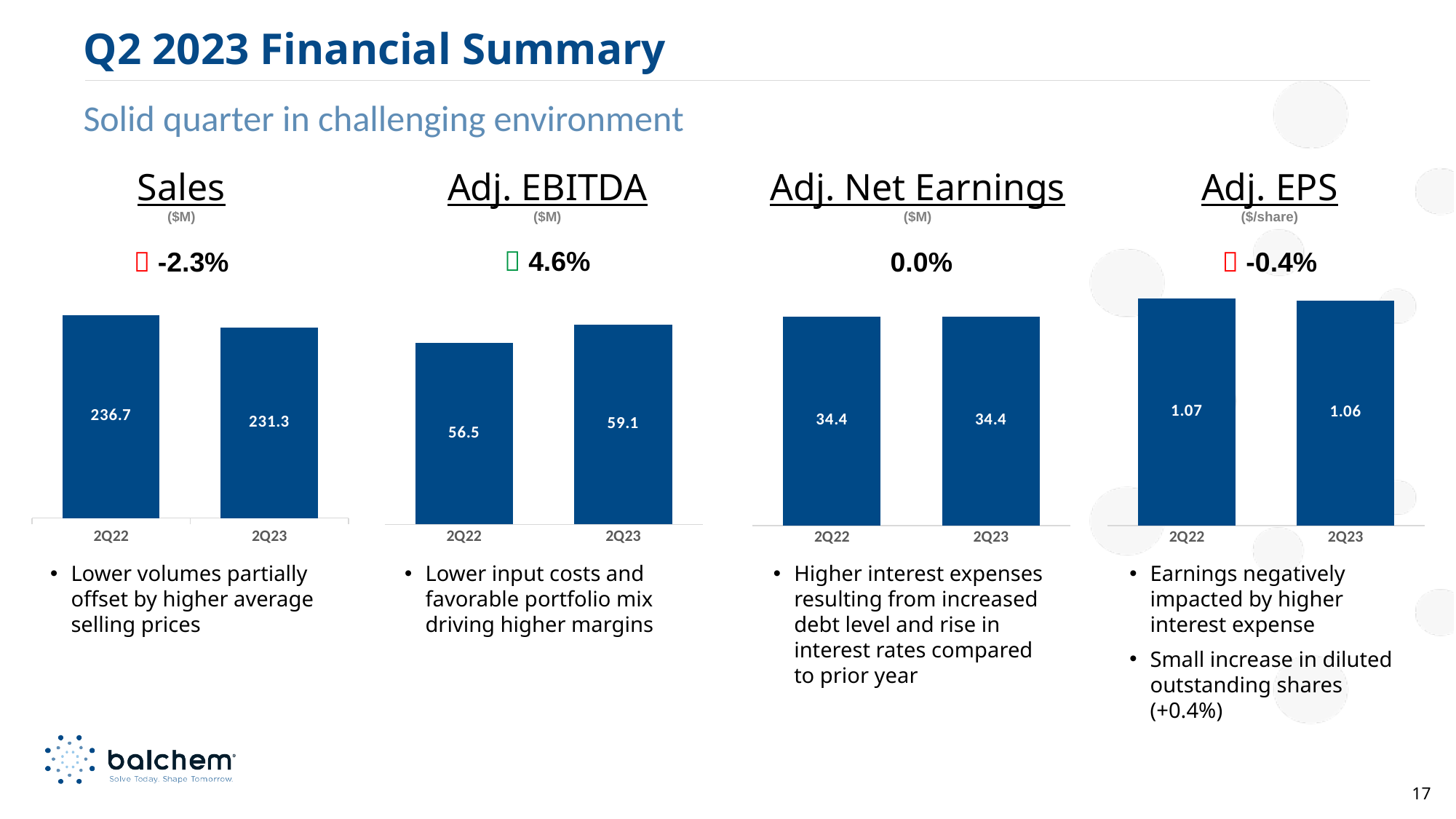
How many bars does the Adj. Net Earnings chart show? 2 In the Sales chart, what is the value for 2Q23? 231.3 In the Adj. EPS chart, is the value for 2Q22 larger or smaller than the value for 2Q23? larger In the Sales chart, which period has the lower value? 2Q23 In the Sales chart, what is the difference between the 2Q22 and 2Q23 values? 5.4 What type of chart is used for the Sales data? bar chart In the Adj. EBITDA chart, what is the value for 2Q23? 59.1 In the Adj. EBITDA chart, which period has the higher value? 2Q23 In the Adj. EBITDA chart, what is the difference between the 2Q23 and 2Q22 values? 2.6 In the Adj. Net Earnings chart, what is the value for 2Q22? 34.4 In the Sales chart, what is the value for 2Q22? 236.7 In the Adj. EPS chart, what is the value for 2Q23? 1.06